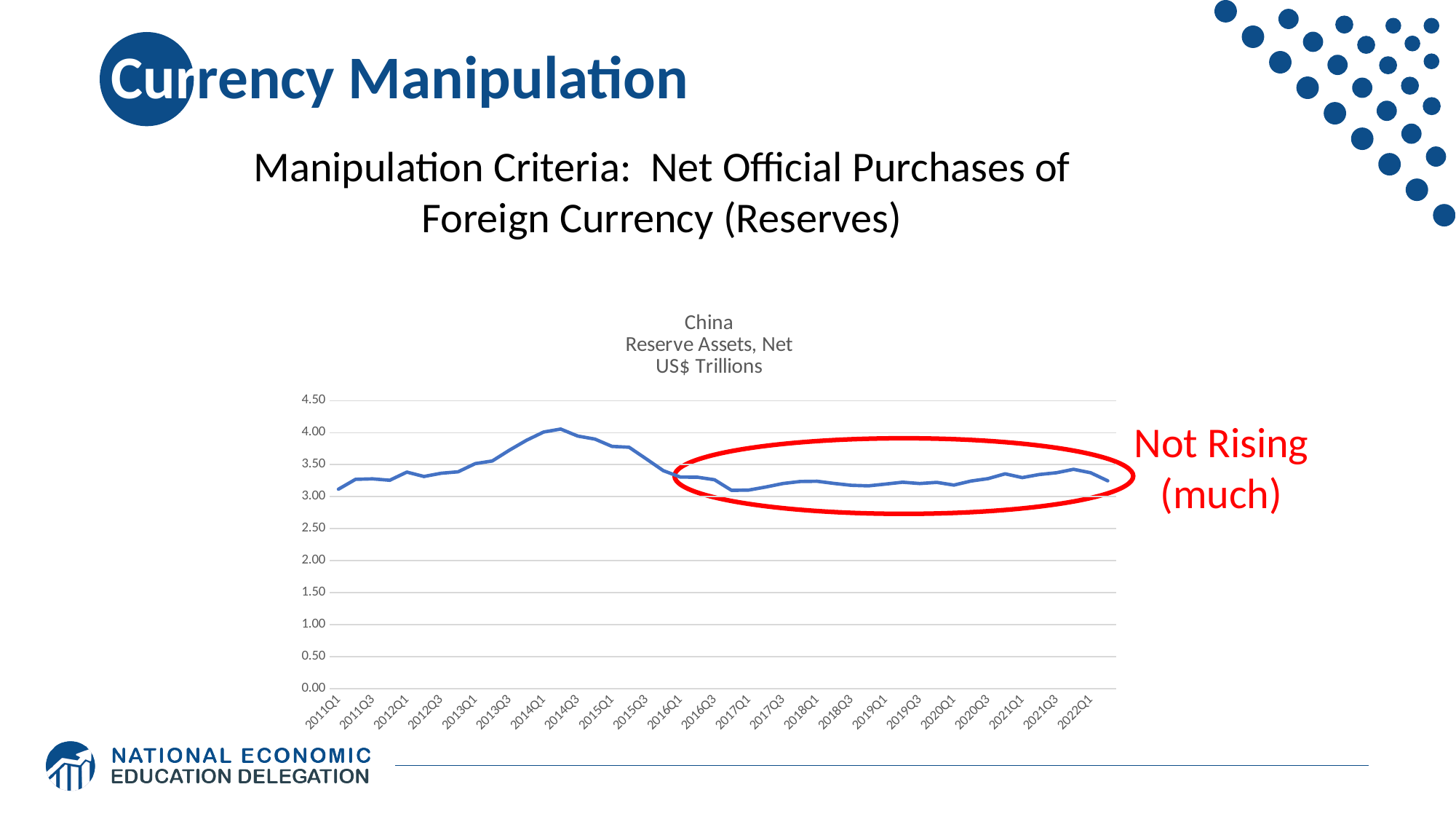
Is the value for 2011Q1 greater or less than 3.00? greater What country does the chart's title say the reserve assets data is for? China Is the value for 2022Q1 greater or less than 3.50? less Is the value for 2019Q1 greater or less than 3.00? greater What kind of chart is shown on the slide? line chart In which year does the line reach its highest point? 2014 Do the values rise or fall between 2011Q1 and 2014Q1? rise Which is larger, the value for 2014Q3 or the value for 2017Q1? 2014Q3 In what units are the values on the chart expressed, according to the chart title? US$ Trillions Do the values rise or fall between 2014Q3 and 2016Q3? fall